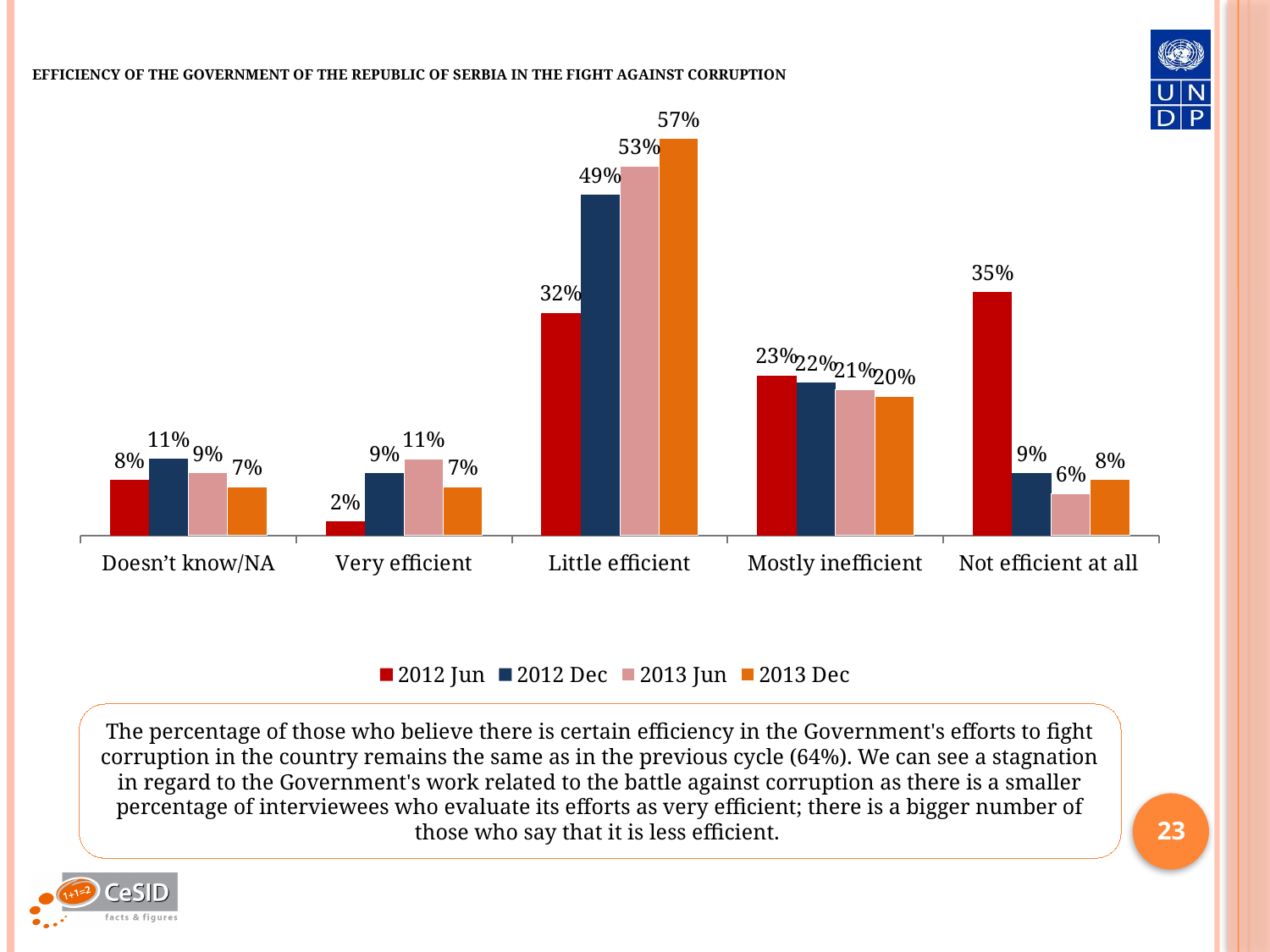
What percentage of respondents said the Government was 'Little efficient' in 2013 Dec? 57% Which category has the lowest value for the 2012 Jun series? Very efficient Across the four survey waves, do the values for 'Mostly inefficient' rise or fall over time? Fall What is the difference between the 2013 Dec and 2012 Jun values for 'Little efficient'? 25 percentage points What kind of chart is shown on the slide? Bar chart Which is larger for 'Not efficient at all': the 2012 Jun value or the 2012 Dec value? 2012 Jun What is the value for 'Not efficient at all' in 2012 Jun? 35% What is the value for 'Very efficient' in 2012 Jun? 2% Which category has the highest value for the 2013 Dec series? Little efficient What is the value for 'Mostly inefficient' in 2013 Jun? 21% How many series does the legend list? 4 How many response categories are shown on the x axis? 5